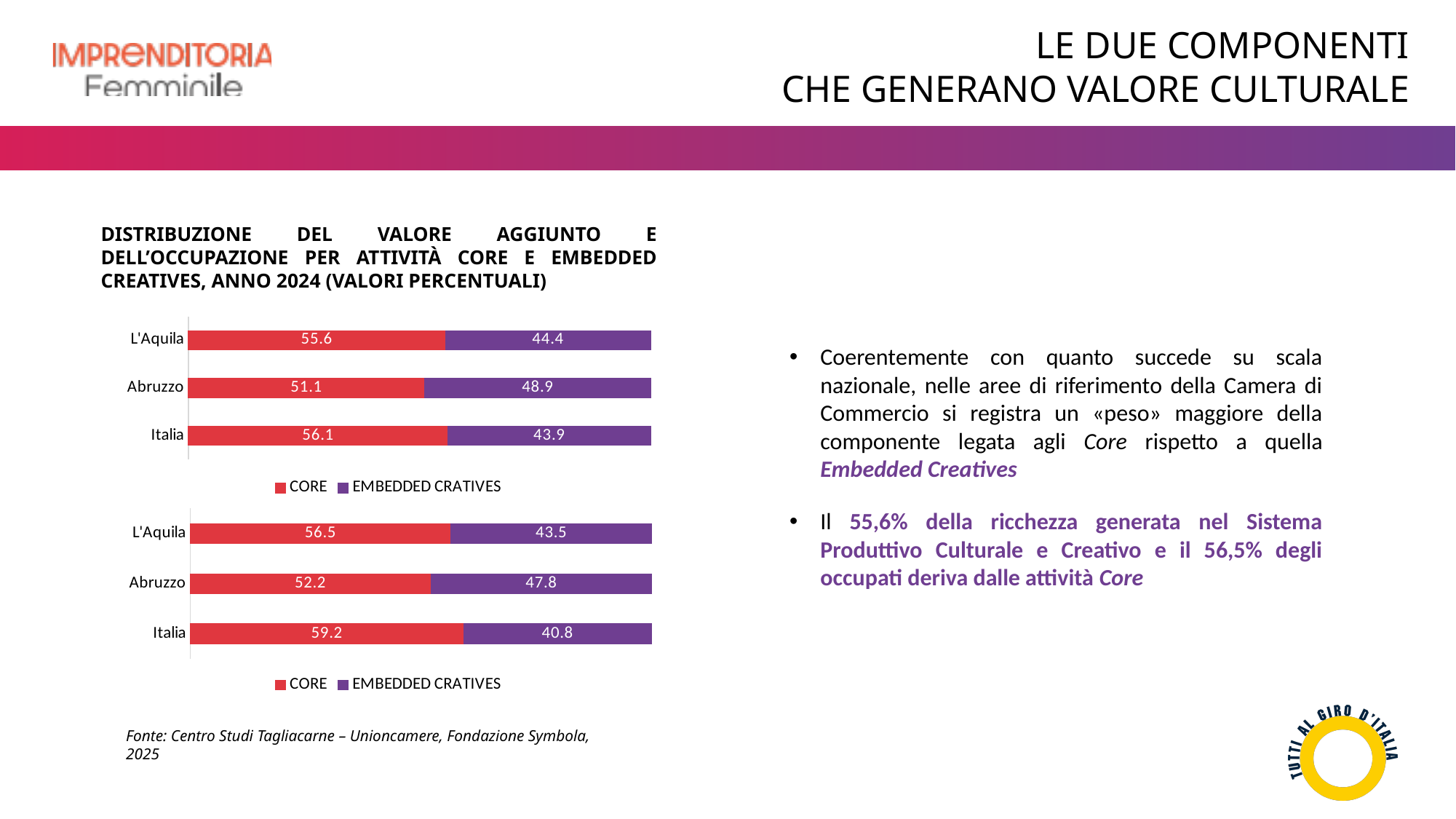
What type of chart is the upper chart? stacked bar chart In the upper chart, what is the CORE value for L'Aquila? 55.6 In the upper chart, is the CORE value for Abruzzo larger or smaller than the CORE value for L'Aquila? smaller In the lower chart, which category has the lowest CORE value? Abruzzo In the upper chart, what is the EMBEDDED CRATIVES value for Abruzzo? 48.9 How many categories are shown in the lower chart? 3 In the upper chart, which category has the highest CORE value? Italia In the lower chart, what is the total of the stacked bar for Abruzzo? 100 How many series does the legend of the upper chart list? 2 In the lower chart, what is the difference between the CORE values for Italia and Abruzzo? 7.0 In the lower chart, what is the EMBEDDED CRATIVES value for L'Aquila? 43.5 In the lower chart, what is the CORE value for Italia? 59.2